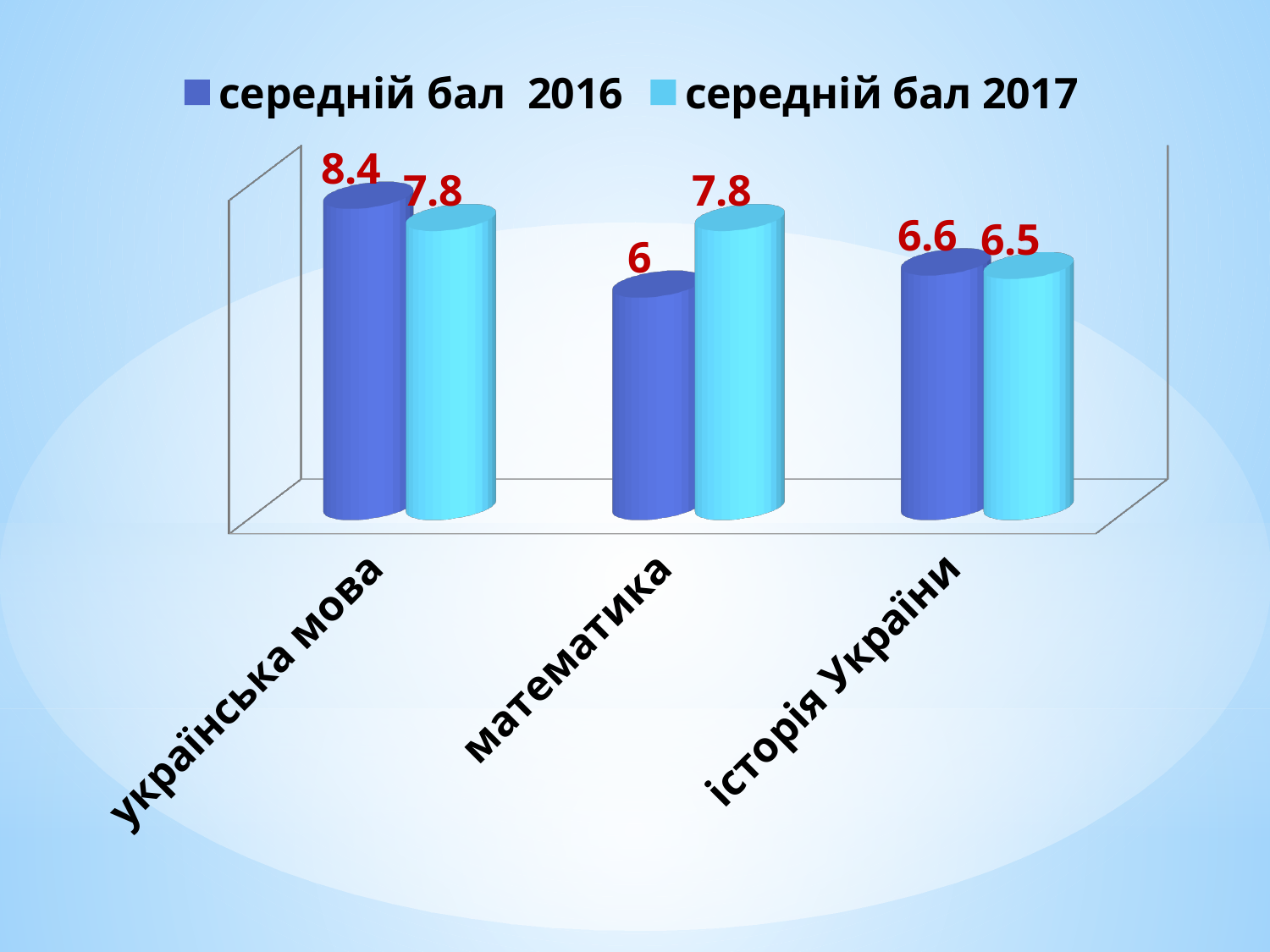
Which category has the highest value in the середній бал 2016 series? українська мова What kind of chart is shown on the slide? bar chart What are the two legend entries of the chart? середній бал 2016 and середній бал 2017 Which is larger for українська мова: середній бал 2016 or середній бал 2017? середній бал 2016 What is the value for математика in the середній бал 2017 series? 7.8 How many series does the legend list? 2 What is the difference between the середній бал 2017 and середній бал 2016 values for математика? 1.8 What is the value for історія України in the середній бал 2017 series? 6.5 Which category has the lowest value in the середній бал 2016 series? математика What is the value for історія України in the середній бал 2016 series? 6.6 What is the value for українська мова in the середній бал 2016 series? 8.4 How many categories are shown on the x axis? 3